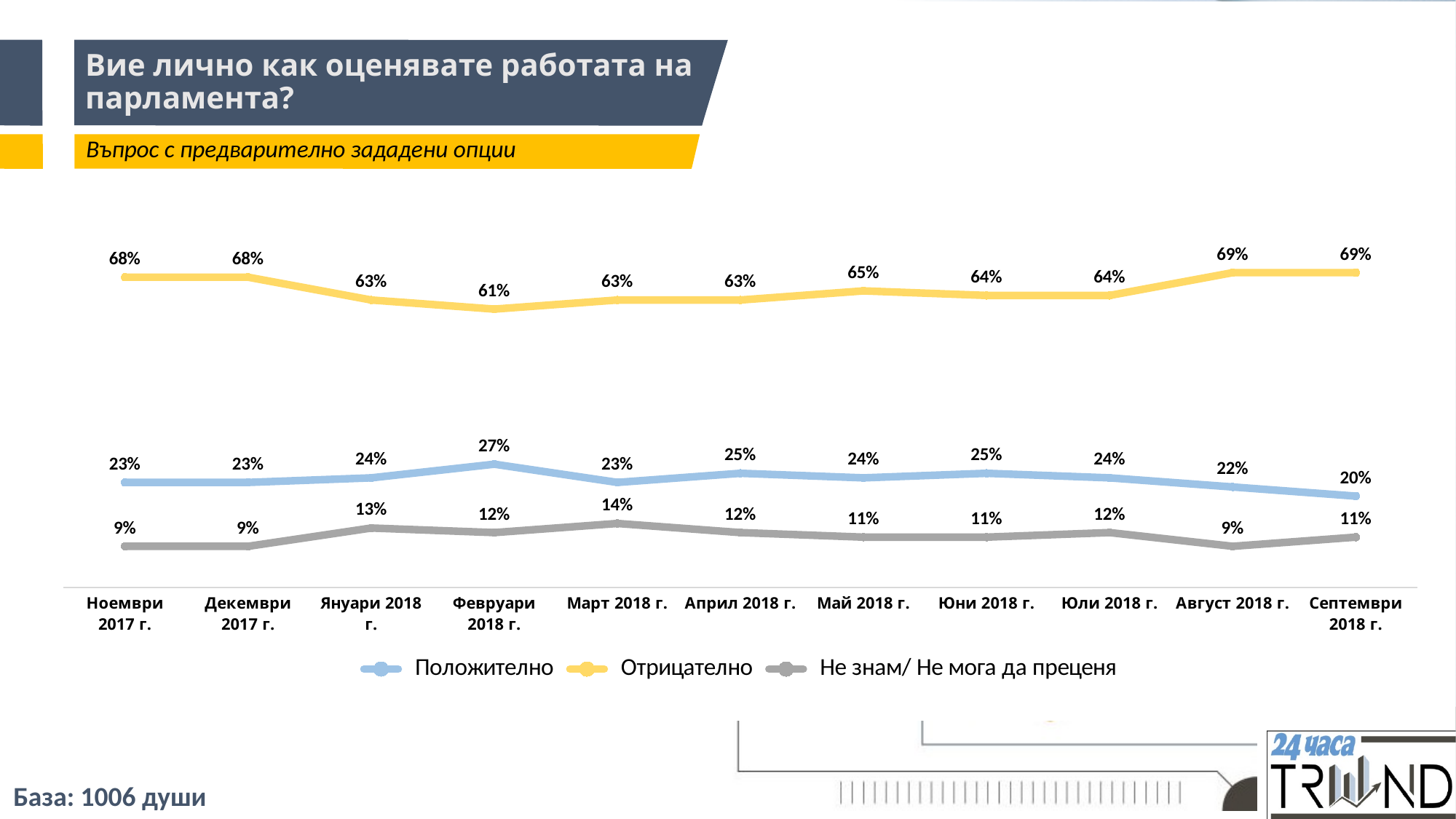
How many time points are plotted along the x axis? 11 What colour is the line for Отрицателно? Yellow Which is larger in Януари 2018 г.: Положително or Не знам/ Не мога да преценя? Положително What type of chart is shown on the slide? Line chart In which month does the Отрицателно series reach its lowest value? Февруари 2018 г. What is the value for Положително in Септември 2018 г.? 20% Does the Положително series rise or fall from Юли 2018 г. to Септември 2018 г.? Fall In which month does the Положително series reach its highest value? Февруари 2018 г. What is the difference between Отрицателно and Положително in Септември 2018 г.? 49 percentage points How many series does the legend list? 3 What is the value for Не знам/ Не мога да преценя in Март 2018 г.? 14% What is the value for Отрицателно in Февруари 2018 г.? 61%